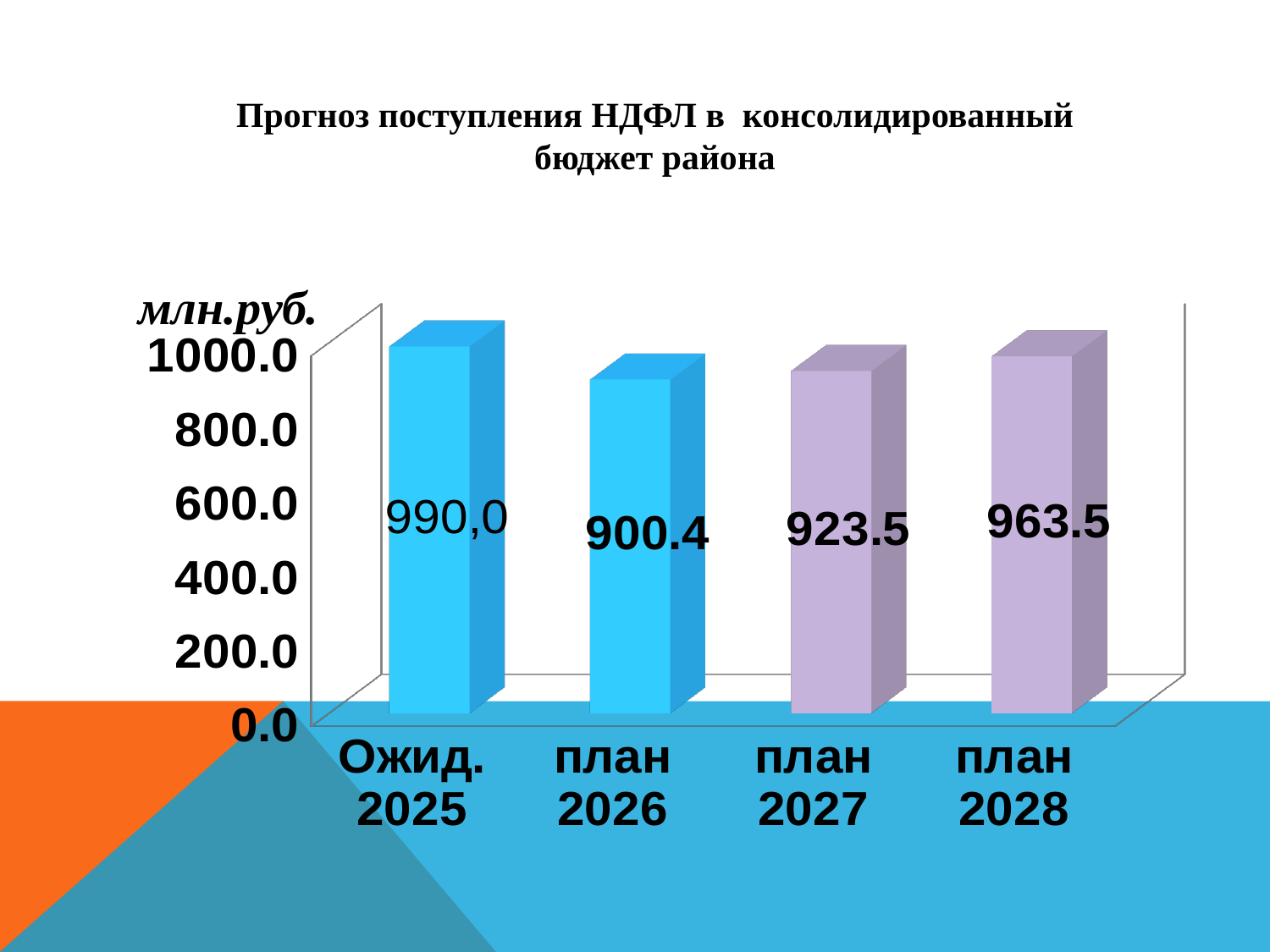
What is the value for план 2027? 923.5 What is the value for Ожид. 2025? 990,0 Is the value for план 2026 greater or less than 1000.0? less Which is larger, the value for план 2027 or the value for план 2026? план 2027 What is the difference between the values for план 2028 and план 2027? 40.0 Which category has the lowest value? план 2026 What unit is shown on the vertical axis of the chart? млн.руб. What is the value for план 2026? 900.4 How many categories are shown on the x axis? 4 Which category has the highest value? Ожид. 2025 What is the value for план 2028? 963.5 What kind of chart is shown on the slide? bar chart